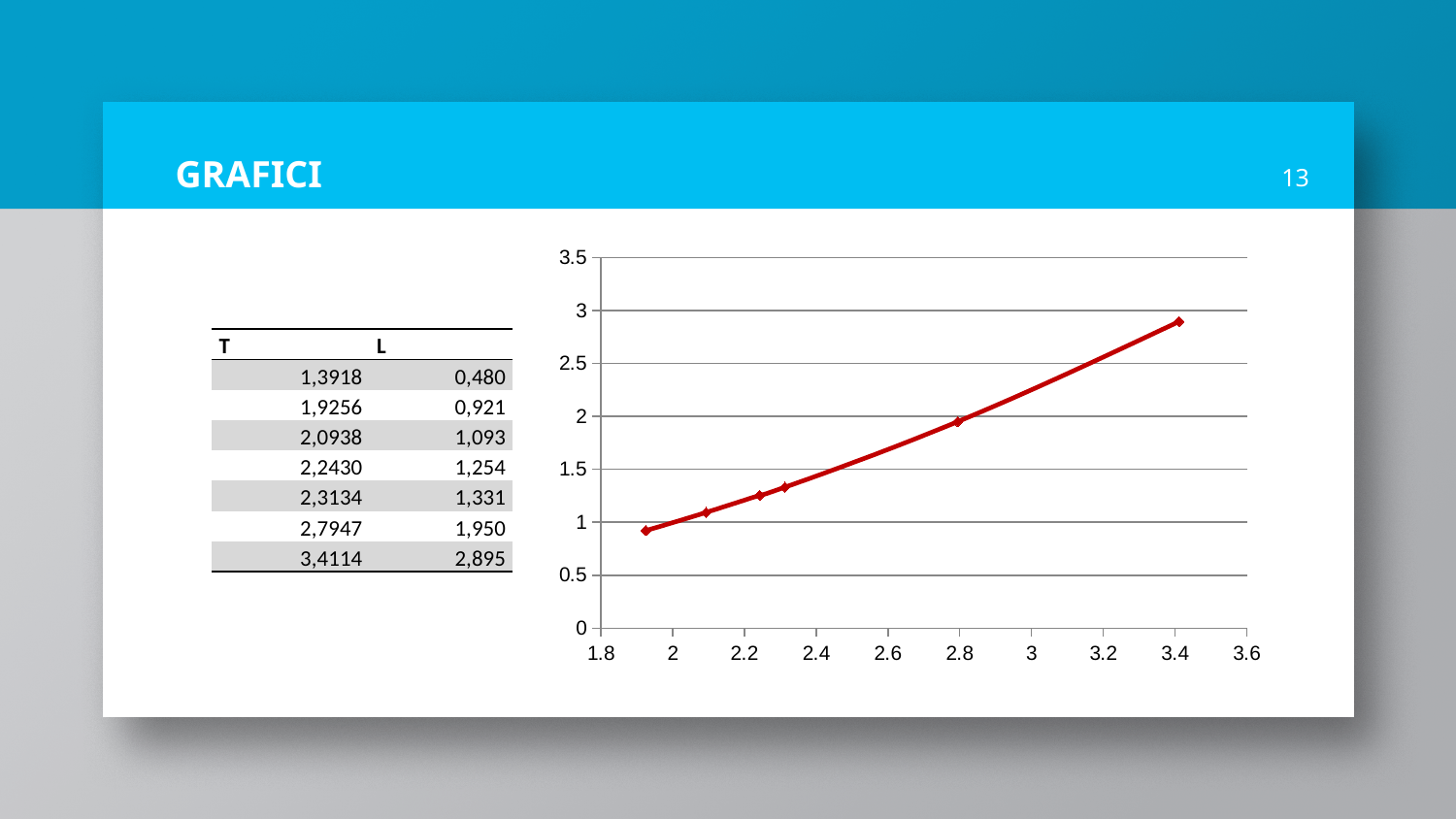
As the x value increases, does the plotted line rise or fall? rise Is the value of the plotted point near x = 2.3 greater or less than 2? less How many data points are plotted on the line chart? 6 Is the value of the plotted point near x = 2.8 greater or less than 1.5? greater Which plotted point has a larger value: the one near x = 2.8 or the one near x = 2.1? the one near x = 2.8 What is the highest value labelled on the y axis? 3.5 What kind of chart is shown on the slide? line chart What colour is the plotted line? red Is the value of the leftmost plotted point (near x = 1.9) greater or less than 1.5? less